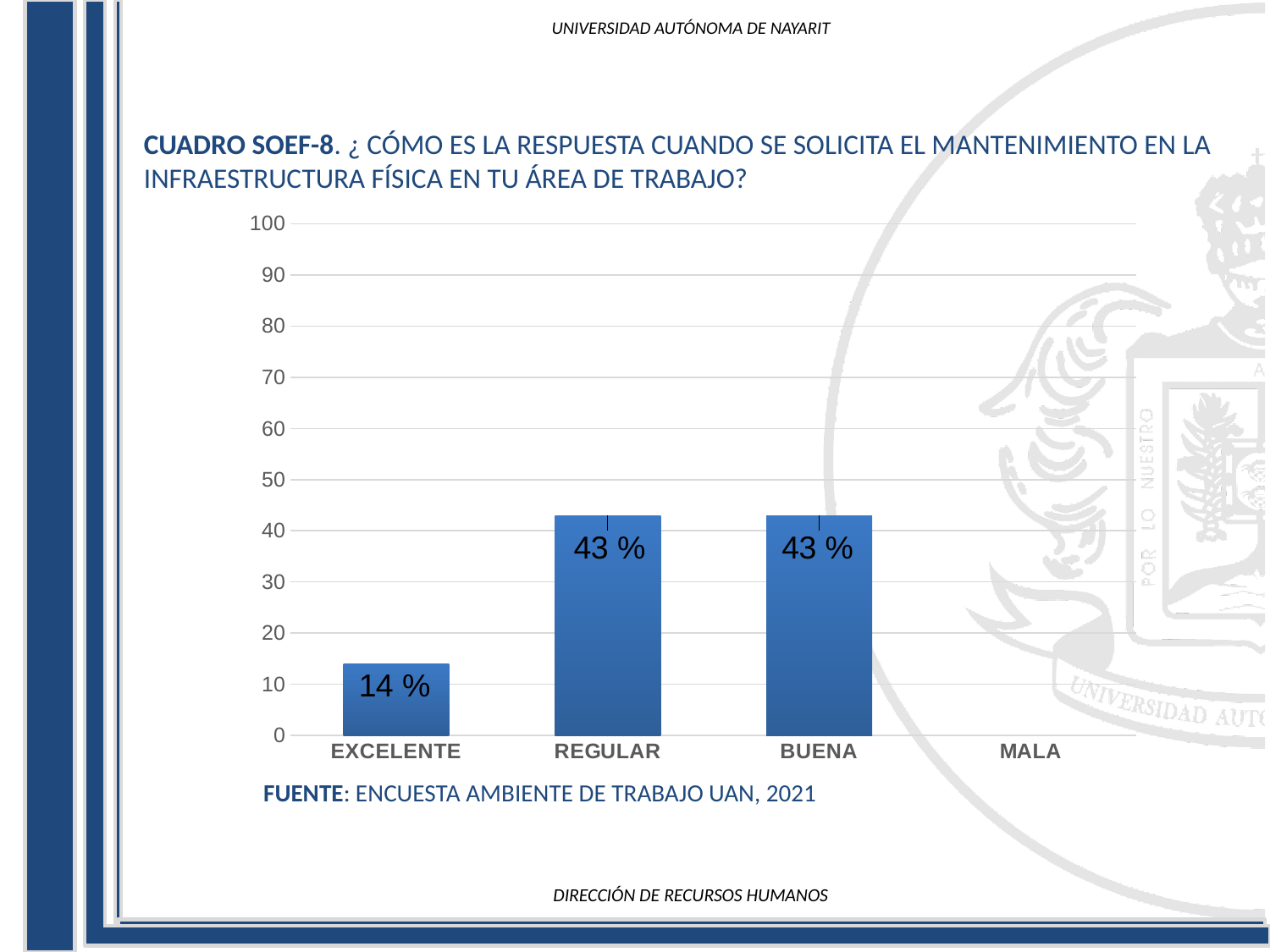
How many categories are shown on the x axis? 4 What source is cited below the chart? ENCUESTA AMBIENTE DE TRABAJO UAN, 2021 Which category has the shortest visible bar? EXCELENTE Is the value for EXCELENTE greater or less than 20? less What is the value for BUENA? 43 % Which is larger, the value for BUENA or the value for EXCELENTE? BUENA What is the difference between the values for REGULAR and EXCELENTE? 29 % What is the value for REGULAR? 43 % Do REGULAR and BUENA have the same value? Yes Is the value for REGULAR greater or less than 40? greater What kind of chart is shown on the slide? Bar chart What is the value for EXCELENTE? 14 %